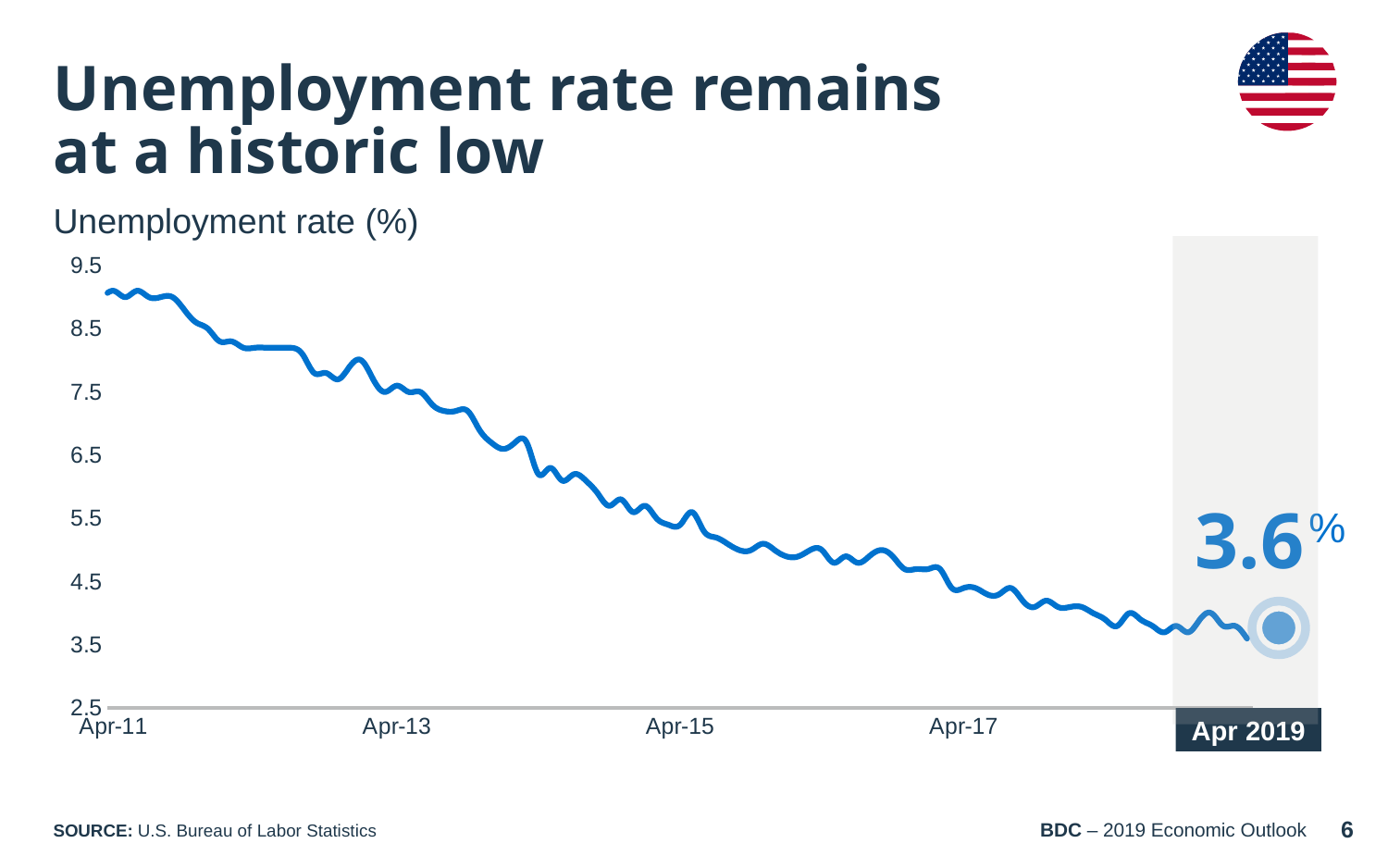
Which is larger, the unemployment rate at Apr-13 or at Apr-17? Apr-13 Which of the labelled dates on the x axis has the highest unemployment rate? Apr-11 Is the value for Apr-11 greater or less than 8.5? greater Which of the labelled dates on the x axis has the lowest unemployment rate? Apr 2019 Does the unemployment rate rise or fall from Apr-11 to Apr 2019? Fall What is the title of the chart? Unemployment rate (%) Is the value for Apr-11 greater or less than 9.5? less What is the unemployment rate shown for Apr 2019? 3.6% What kind of chart is used to show the unemployment rate? Line chart Is the value for Apr-15 greater or less than 6.5? less How many date labels are shown on the x axis? 5